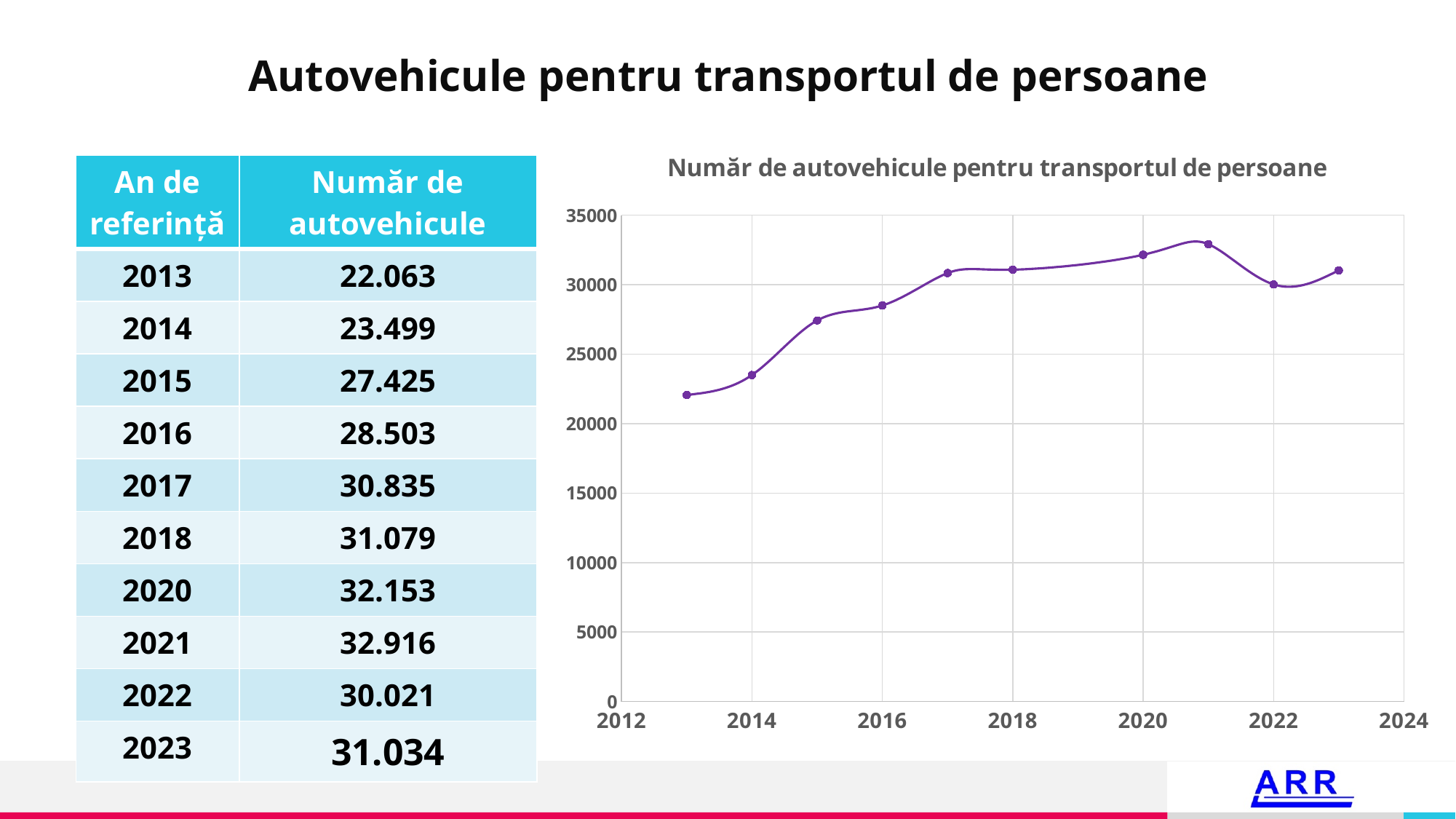
What is the number of vehicles for 2021 according to the slide? 32.916 Is the value for 2016 on the chart greater or less than 30000? less In which year does the line chart show its lowest value? 2013 How many data points are plotted on the line chart? 10 What is the difference between the values for 2023 and 2022 shown on the slide? 1.013 What is the title of the chart? Număr de autovehicule pentru transportul de persoane In which year does the line chart reach its highest value? 2021 What type of chart is shown on the slide? line chart What is the number of vehicles for 2013 according to the slide? 22.063 Which year has the larger value, 2015 or 2022? 2022 Does the line generally rise or fall between 2013 and 2021? rise Is the value for 2013 on the chart greater or less than 25000? less